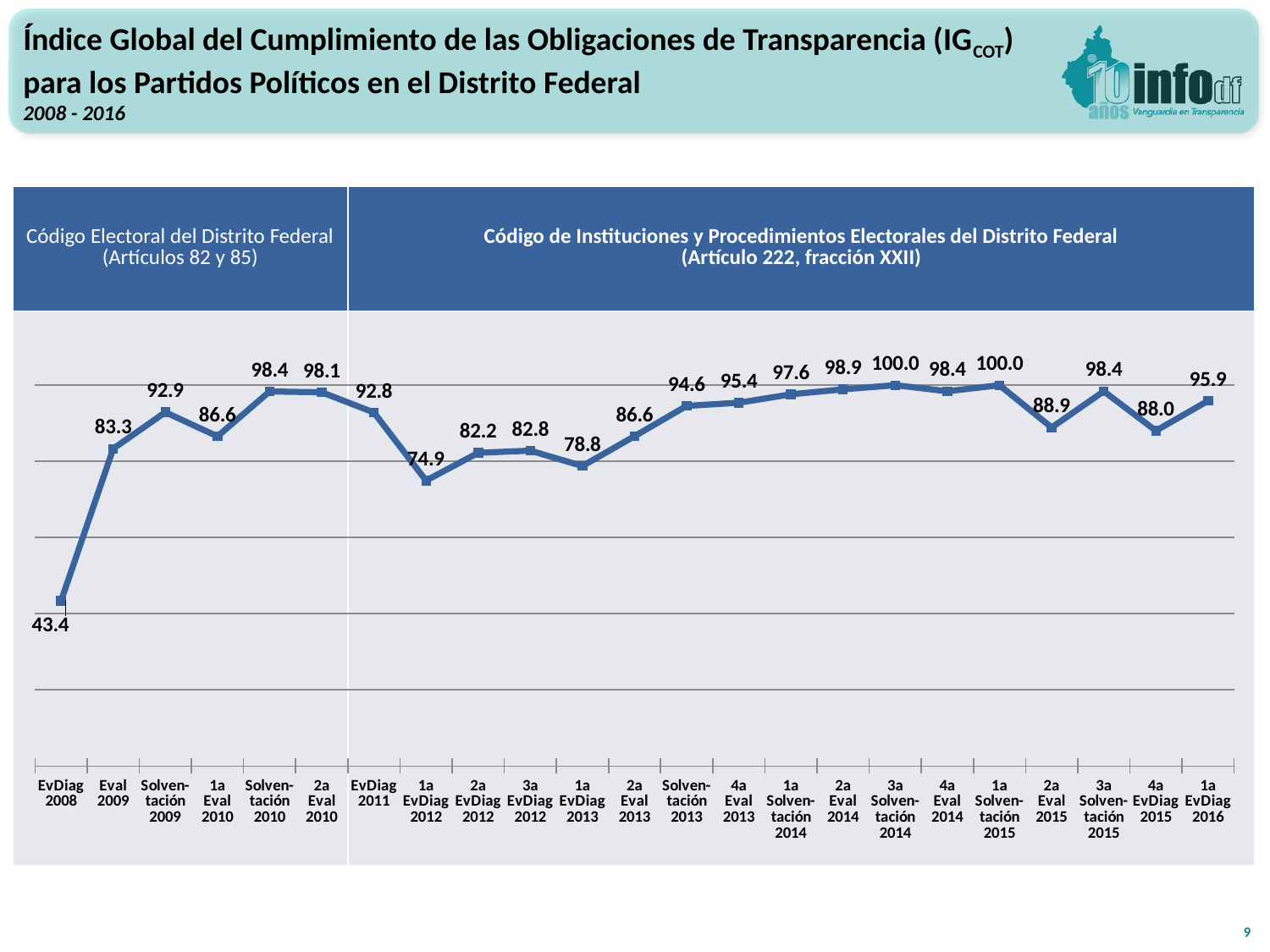
What is the value for 1a EvDiag 2012? 74.9 What is the value for 1a EvDiag 2016? 95.9 Which is larger, the value for 2a EvDiag 2012 or the value for 1a EvDiag 2013? 2a EvDiag 2012 Which point has the lowest value on the chart? EvDiag 2008 What is the value for Solventación 2010? 98.4 How many data points are plotted on the chart? 23 What is the difference between the values for 3a Solventación 2015 and 4a EvDiag 2015? 10.4 Do the values rise or fall from EvDiag 2008 to Solventación 2009? Rise What kind of chart is shown on the slide? Line chart What is the value for EvDiag 2008? 43.4 What is the highest value shown on the chart? 100.0 What is the difference between the values for Eval 2009 and EvDiag 2008? 39.9